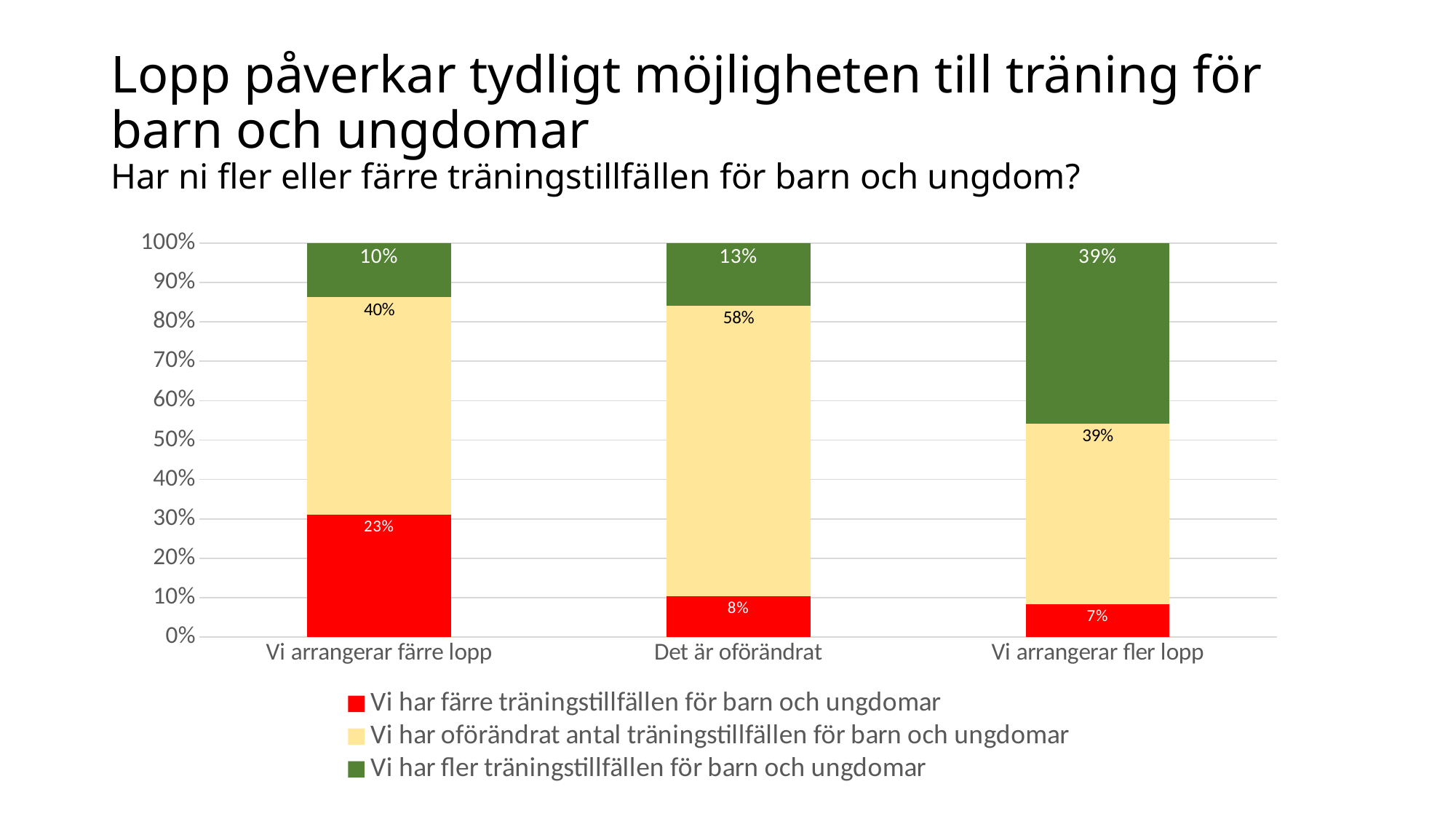
What colour represents 'Vi har fler träningstillfällen för barn och ungdomar' in the legend? green Which category has the lowest value for 'Vi har färre träningstillfällen för barn och ungdomar'? Vi arrangerar fler lopp What is the difference between the 'Vi har fler träningstillfällen för barn och ungdomar' values for 'Vi arrangerar fler lopp' and 'Vi arrangerar färre lopp'? 29% What is the value for 'Vi har fler träningstillfällen för barn och ungdomar' in the 'Vi arrangerar fler lopp' bar? 39% Which is larger: the 'Vi har färre träningstillfällen för barn och ungdomar' value for 'Vi arrangerar färre lopp' or for 'Det är oförändrat'? Vi arrangerar färre lopp Which category has the highest value for 'Vi har fler träningstillfällen för barn och ungdomar'? Vi arrangerar fler lopp What is the value for 'Vi har färre träningstillfällen för barn och ungdomar' in the 'Det är oförändrat' bar? 8% How many series does the legend list? 3 How many categories are shown on the x axis? 3 What is the value for 'Vi har oförändrat antal träningstillfällen för barn och ungdomar' in the 'Det är oförändrat' bar? 58% What kind of chart is shown on the slide? stacked bar chart What is the value for 'Vi har färre träningstillfällen för barn och ungdomar' in the 'Vi arrangerar färre lopp' bar? 23%